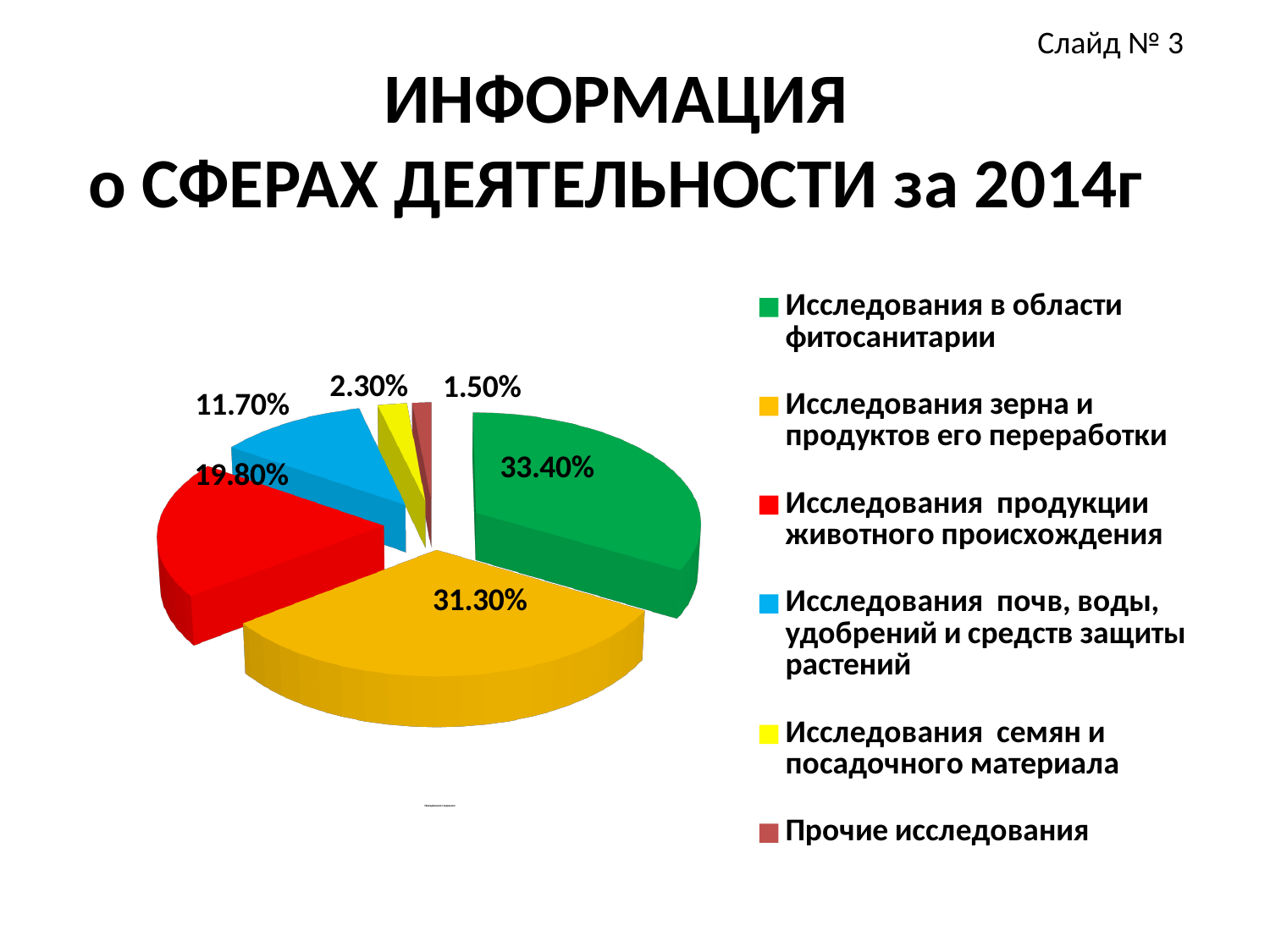
What kind of chart is shown on the slide? Pie chart What percentage is shown for Исследования почв, воды, удобрений и средств защиты растений? 11.70% What percentage is shown for Исследования зерна и продуктов его переработки? 31.30% How many categories does the legend list? 6 What value is printed for Исследования продукции животного происхождения? 19.80% What share is labelled for Прочие исследования? 1.50% Which category has the smallest slice of the pie? Прочие исследования Which is larger: the share for Исследования продукции животного происхождения or for Исследования почв, воды, удобрений и средств защиты растений? Исследования продукции животного происхождения What is the difference between the shares for Исследования в области фитосанитарии and Исследования зерна и продуктов его переработки? 2.10% What colour is the slice for Исследования семян и посадочного материала? Yellow Which category has the largest slice of the pie? Исследования в области фитосанитарии What share of the pie is labelled for Исследования в области фитосанитарии? 33.40%